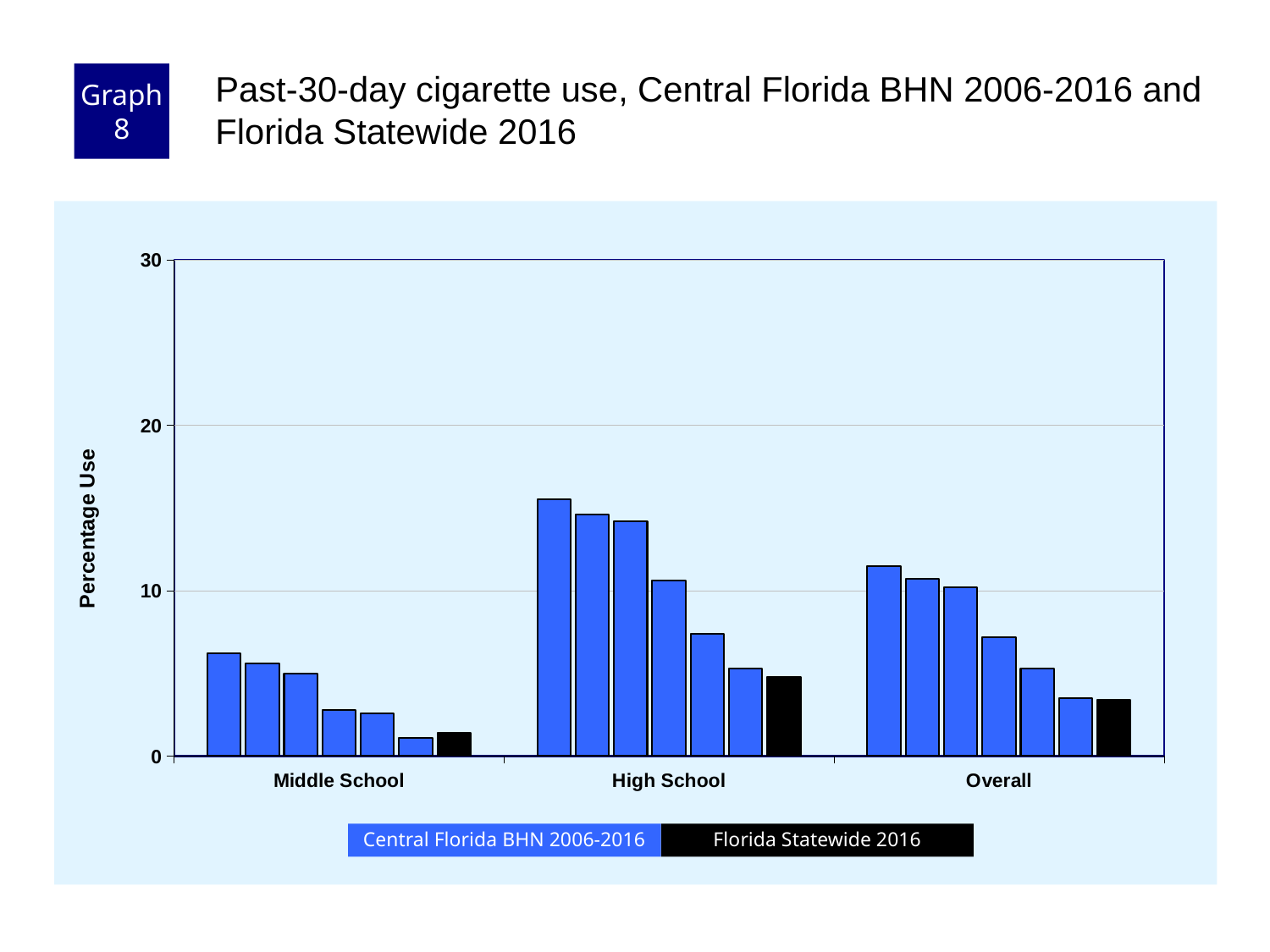
How many categories are shown on the x axis? 3 What colour are the Florida Statewide 2016 bars? black Is the value of the tallest Central Florida BHN bar for High School greater or less than 10? greater Which is larger: the Florida Statewide 2016 bar for High School or the Florida Statewide 2016 bar for Middle School? High School Which category has the lowest bars overall? Middle School Is the value of the Florida Statewide 2016 bar for High School greater or less than 10? less How many series does the legend list? 2 Is the value of the tallest Central Florida BHN bar for Middle School greater or less than 10? less Which category has the highest bars overall? High School Within the High School group, do the Central Florida BHN 2006-2016 bars rise or fall from left to right? fall What kind of chart is shown on the slide? bar chart What is the label on the y axis? Percentage Use